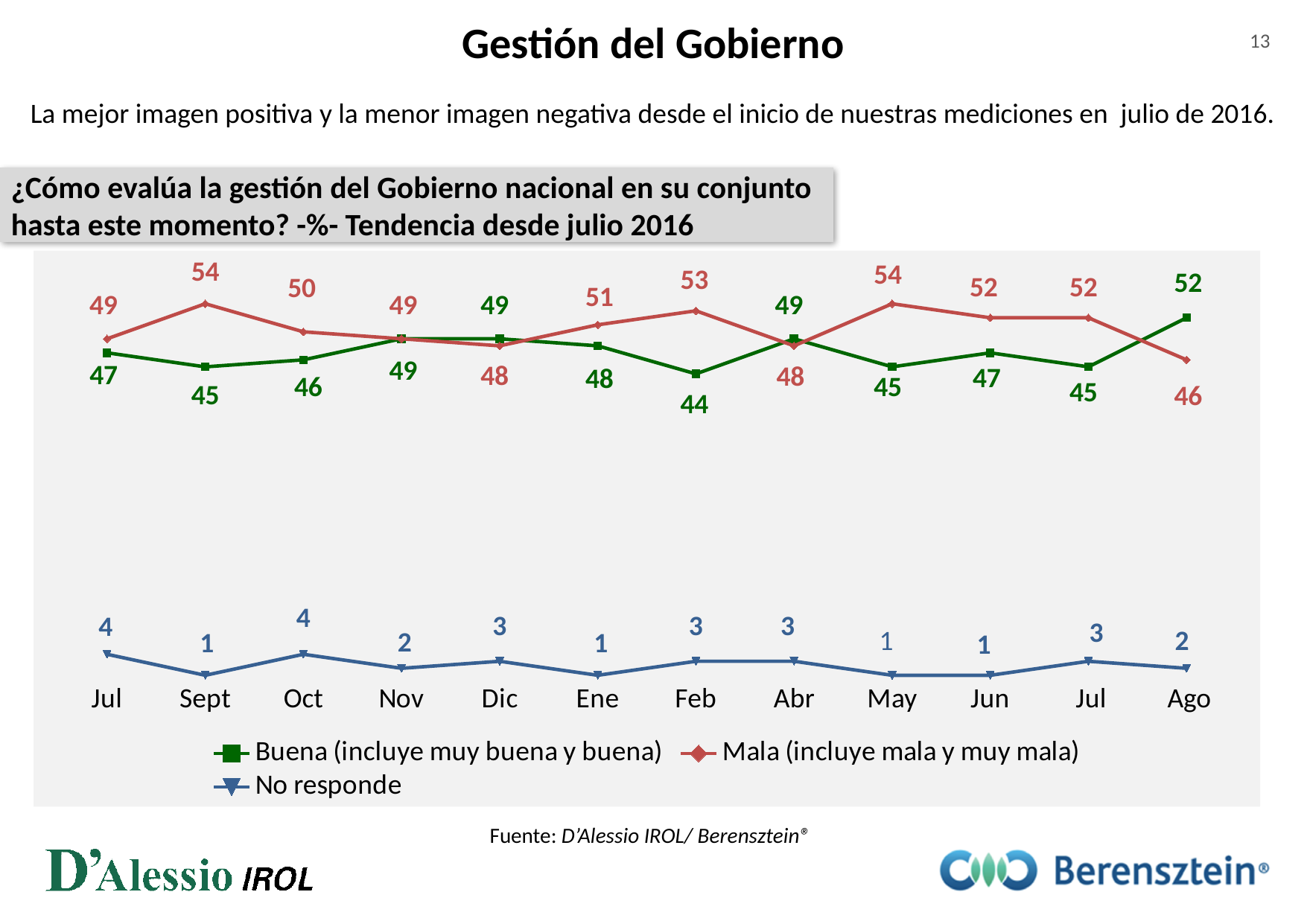
What is the value of the Buena series in Ago? 52 In Feb, how much higher is the Mala value than the Buena value? 9 How many series does the legend list? 3 In which month does the Buena series reach its lowest value? Feb What kind of chart is shown on the slide? Line chart What is the difference between the Mala value in May and the Mala value in Ago? 8 What is the value of the Mala series in Sept? 54 In Ago, which series has the larger value, Buena or Mala? Buena How many months are plotted on the x axis? 12 In which month does the Mala series reach its lowest value? Ago What is the value of the No responde series in Oct? 4 In which month does the Buena series reach its highest value? Ago